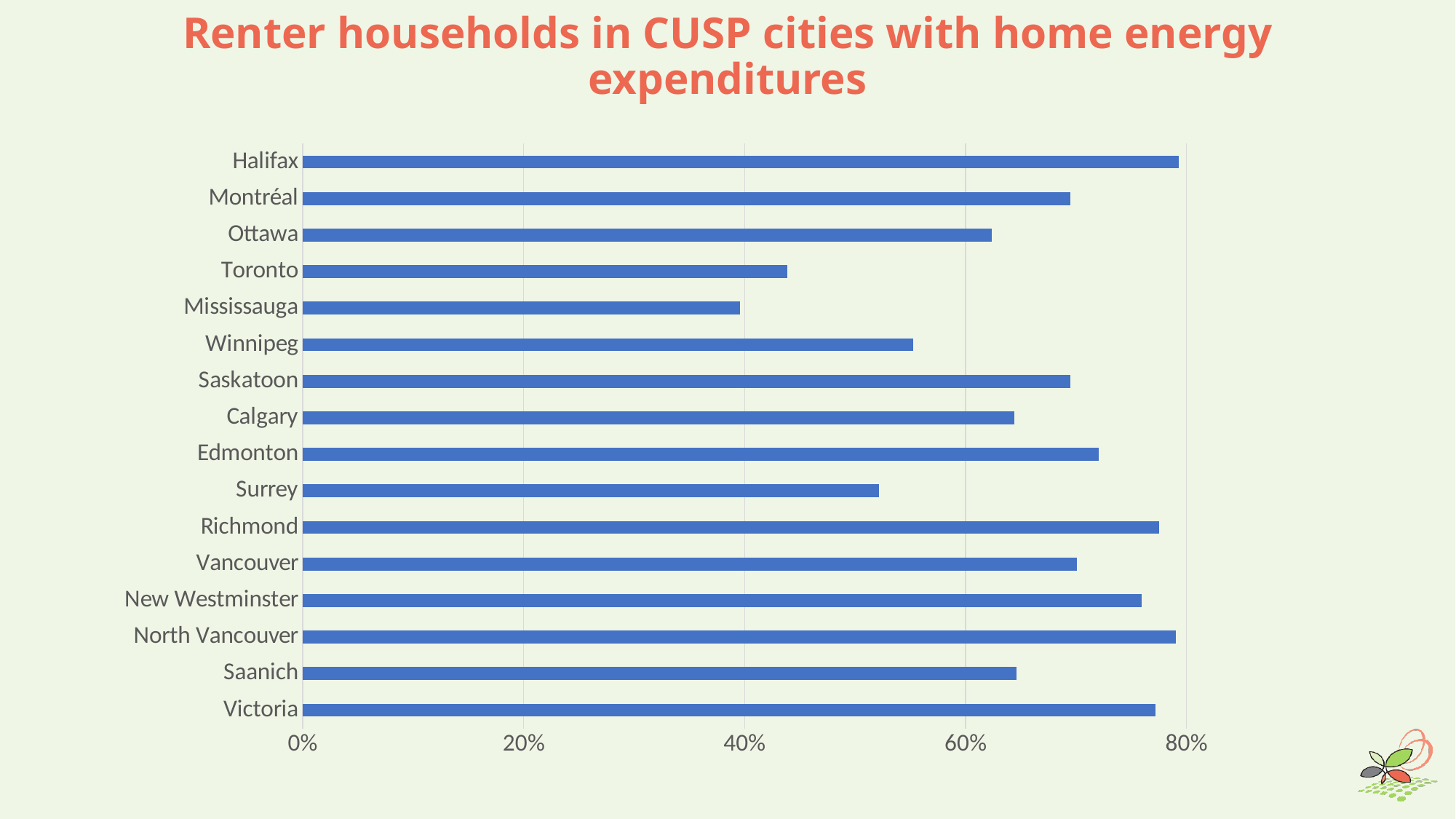
Which has the larger value, Toronto or Winnipeg? Winnipeg Which has the larger value, Ottawa or Richmond? Richmond What is the title of the chart? Renter households in CUSP cities with home energy expenditures Is the value for Edmonton greater or less than 60%? greater What kind of chart is shown on the slide? bar chart Is the value for Winnipeg greater or less than 60%? less Which city has the lowest share of renter households with home energy expenditures? Mississauga How many cities are plotted in the chart? 16 Is the value for Toronto greater or less than 40%? greater Which has the larger value, Surrey or Edmonton? Edmonton